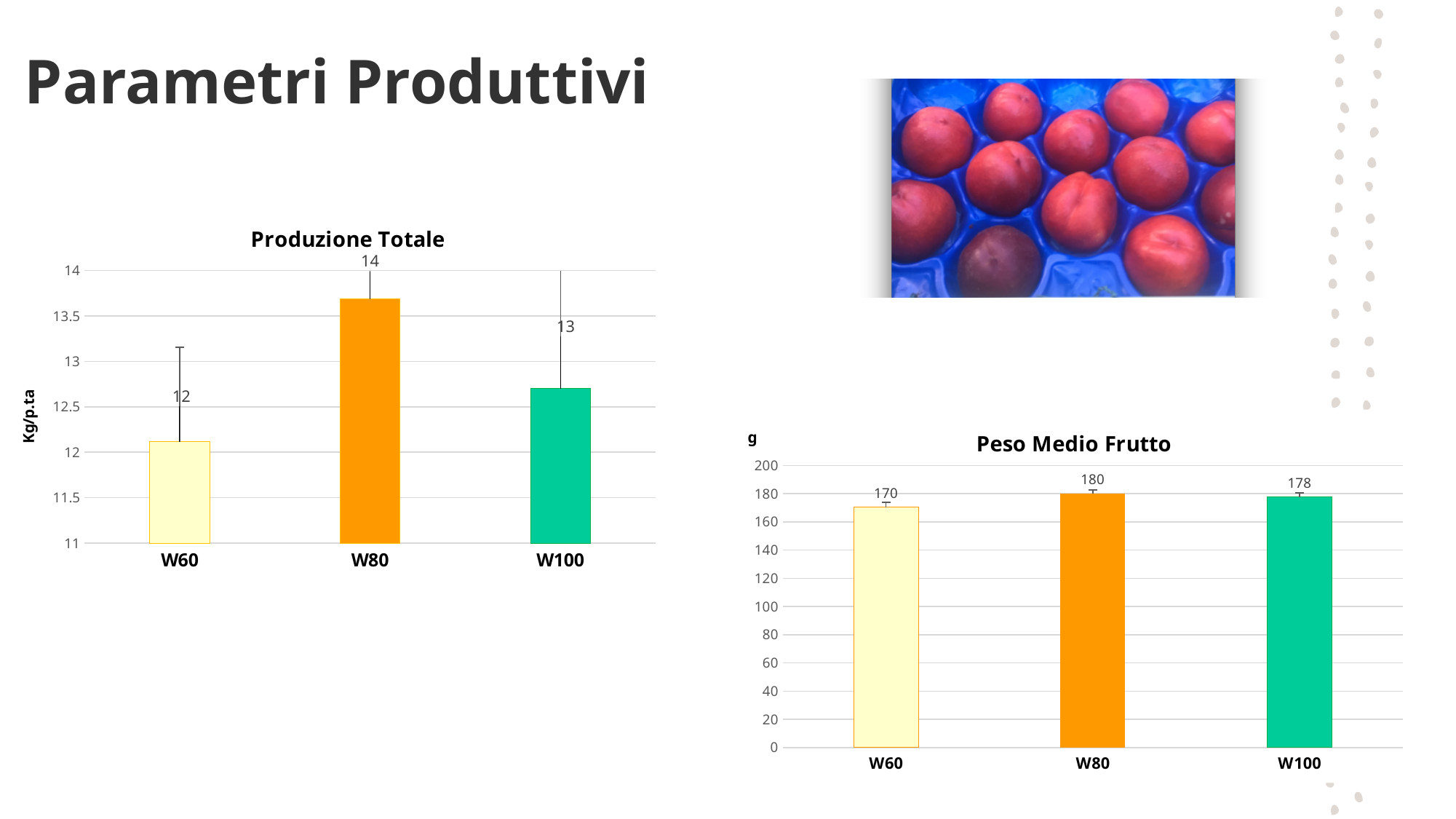
In the Produzione Totale chart, which category has the highest value? W80 In the Peso Medio Frutto chart, which category has the lowest value? W60 In the Produzione Totale chart, what is the value for W80? 14 How many categories are shown in the Peso Medio Frutto chart? 3 In the Produzione Totale chart, is the value for W80 greater or less than 13.5? greater In the Peso Medio Frutto chart, what is the value for W60? 170 In the Peso Medio Frutto chart, what is the difference between the values for W80 and W60? 10 In the Produzione Totale chart, what is the value for W60? 12 What is the y-axis label of the Produzione Totale chart? Kg/p.ta In the Produzione Totale chart, which is larger, the value for W100 or the value for W60? W100 In the Peso Medio Frutto chart, what is the value for W100? 178 What kind of chart is the Produzione Totale chart? bar chart